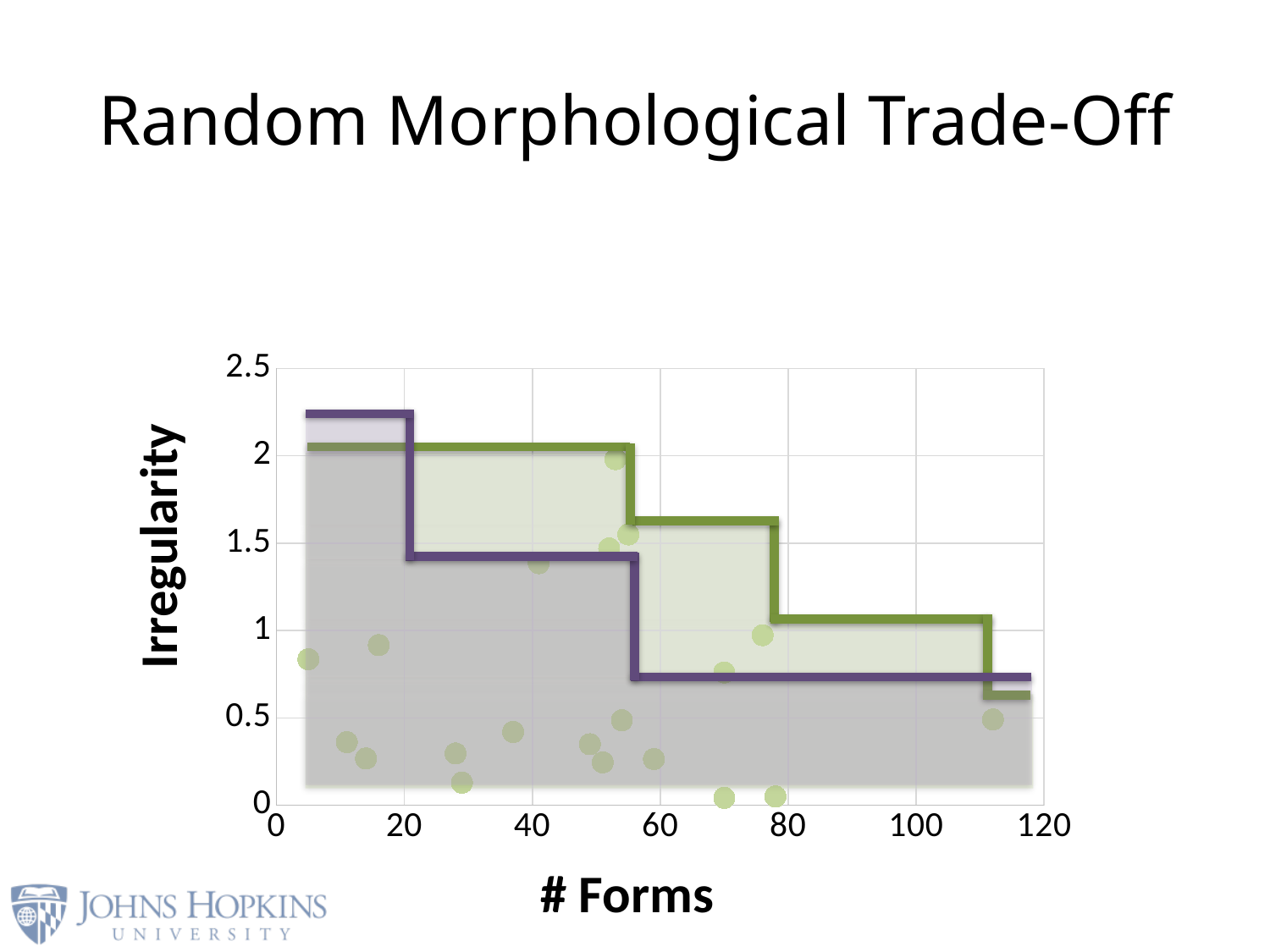
As # Forms increases, do the step lines rise or fall? fall What is the title of the chart? Random Morphological Trade-Off What is the label of the x axis? # Forms Is the value of the green step line at # Forms = 40 greater or less than 1.5? greater Is the value of the purple step line at # Forms = 100 greater or less than 1? less Is the value of the purple step line at # Forms = 10 greater or less than 2? greater How many step lines are drawn on the chart? 2 At # Forms = 10, which step line is higher, the green one or the purple one? purple At # Forms = 40, which step line is higher, the green one or the purple one? green What is the highest tick value shown on the y axis (Irregularity)? 2.5 What is the highest tick value shown on the x axis (# Forms)? 120